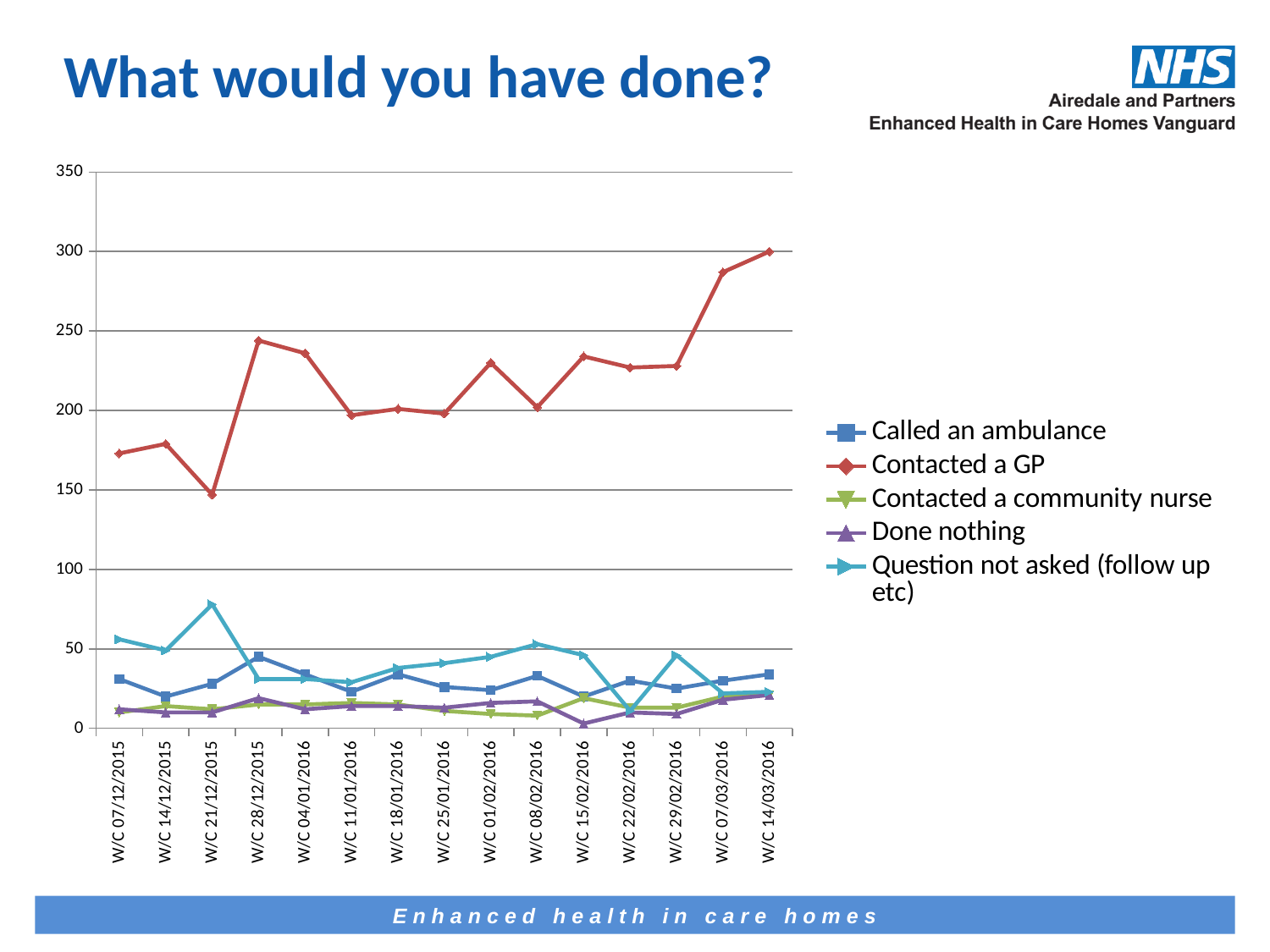
Is the value for 'Contacted a GP' at W/C 21/12/2015 greater or less than 200? less Is the value for 'Question not asked (follow up etc)' at W/C 21/12/2015 greater or less than 50? greater In which week does the 'Contacted a GP' series reach its highest value? W/C 14/03/2016 How many series does the legend list? 5 What is the title of the slide containing the chart? What would you have done? Is the value for 'Contacted a GP' at W/C 07/12/2015 greater or less than 150? greater Which series has the highest values across the whole chart? Contacted a GP Does the 'Contacted a GP' series rise or fall from W/C 29/02/2016 to W/C 14/03/2016? Rise At W/C 21/12/2015, which is larger: 'Question not asked (follow up etc)' or 'Called an ambulance'? Question not asked (follow up etc) In which week does the 'Contacted a GP' series reach its lowest value? W/C 21/12/2015 How many weeks (x-axis categories) are plotted on the chart? 15 What kind of chart is shown on the slide? Line chart